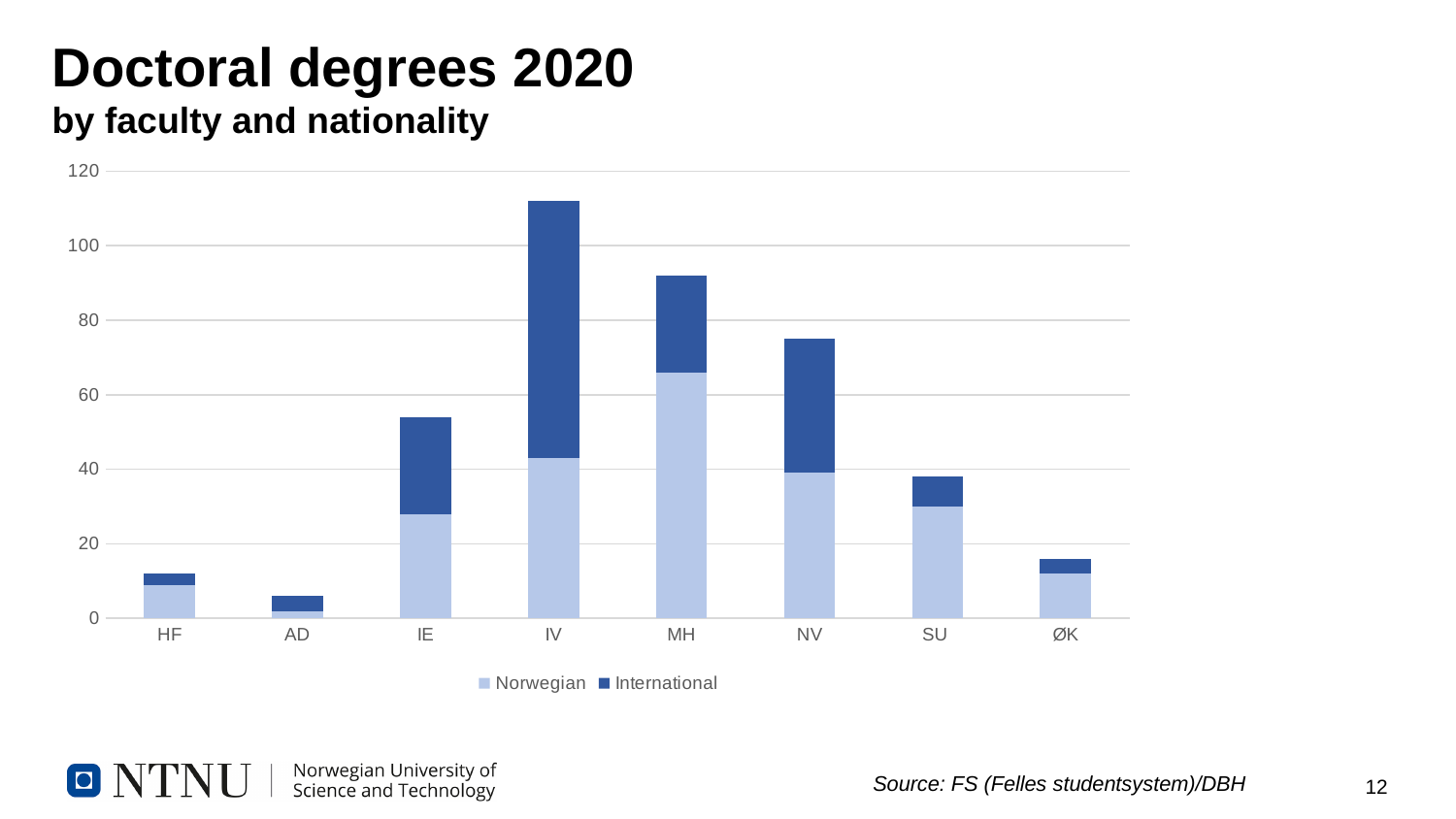
Is the total value for IV greater or less than 100? greater Which faculty has the highest total number of doctoral degrees? IV What kind of chart is shown on the slide? Stacked bar chart Which faculty has the lowest total number of doctoral degrees? AD How many faculties are shown on the x axis? 8 Is the total value for IE greater or less than 40? greater Which series is shown in the darker blue colour? International Which faculty has a higher total of doctoral degrees, MH or NV? MH Is the total value for AD greater or less than 20? less How many series does the legend list? 2 What is the title of the chart? Doctoral degrees 2020 by faculty and nationality